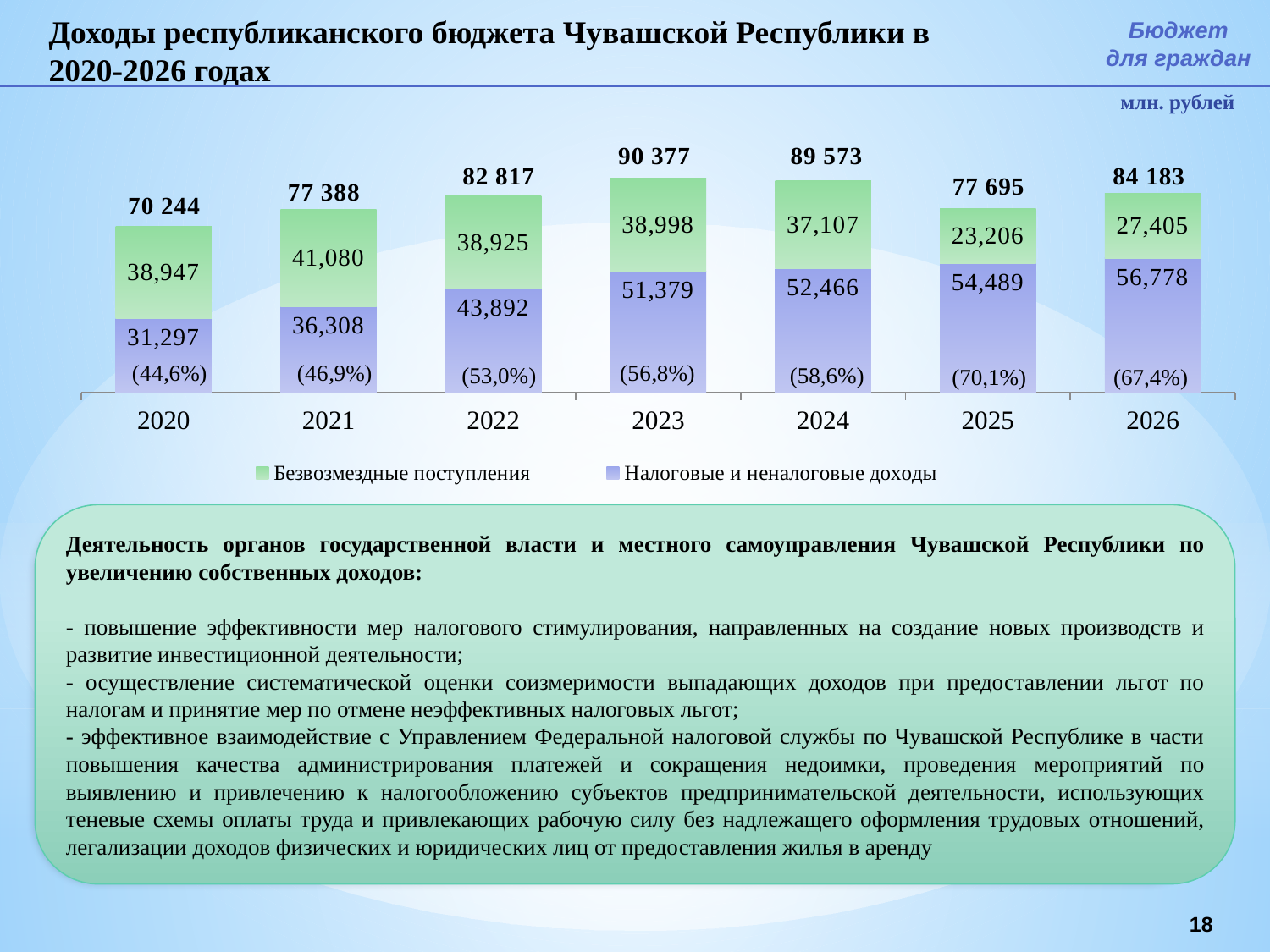
What is the difference between the total revenue for 2023 and 2024? 804 What is the total revenue shown above the bar for 2023? 90 377 How many series does the chart legend list? 2 What is the value of Налоговые и неналоговые доходы for 2026? 56,778 Which year has the highest total revenue? 2023 What type of chart is shown on the slide? Stacked bar chart Which year has the lowest value of Безвозмездные поступления? 2025 What percentage is shown in parentheses for 2025? (70,1%) Do the values of Налоговые и неналоговые доходы rise or fall from 2020 to 2026? Rise Which is larger: Налоговые и неналоговые доходы in 2022 or Безвозмездные поступления in 2022? Налоговые и неналоговые доходы (43,892) How many years (categories) are shown on the x axis of the chart? 7 What is the value of Безвозмездные поступления for 2021? 41,080